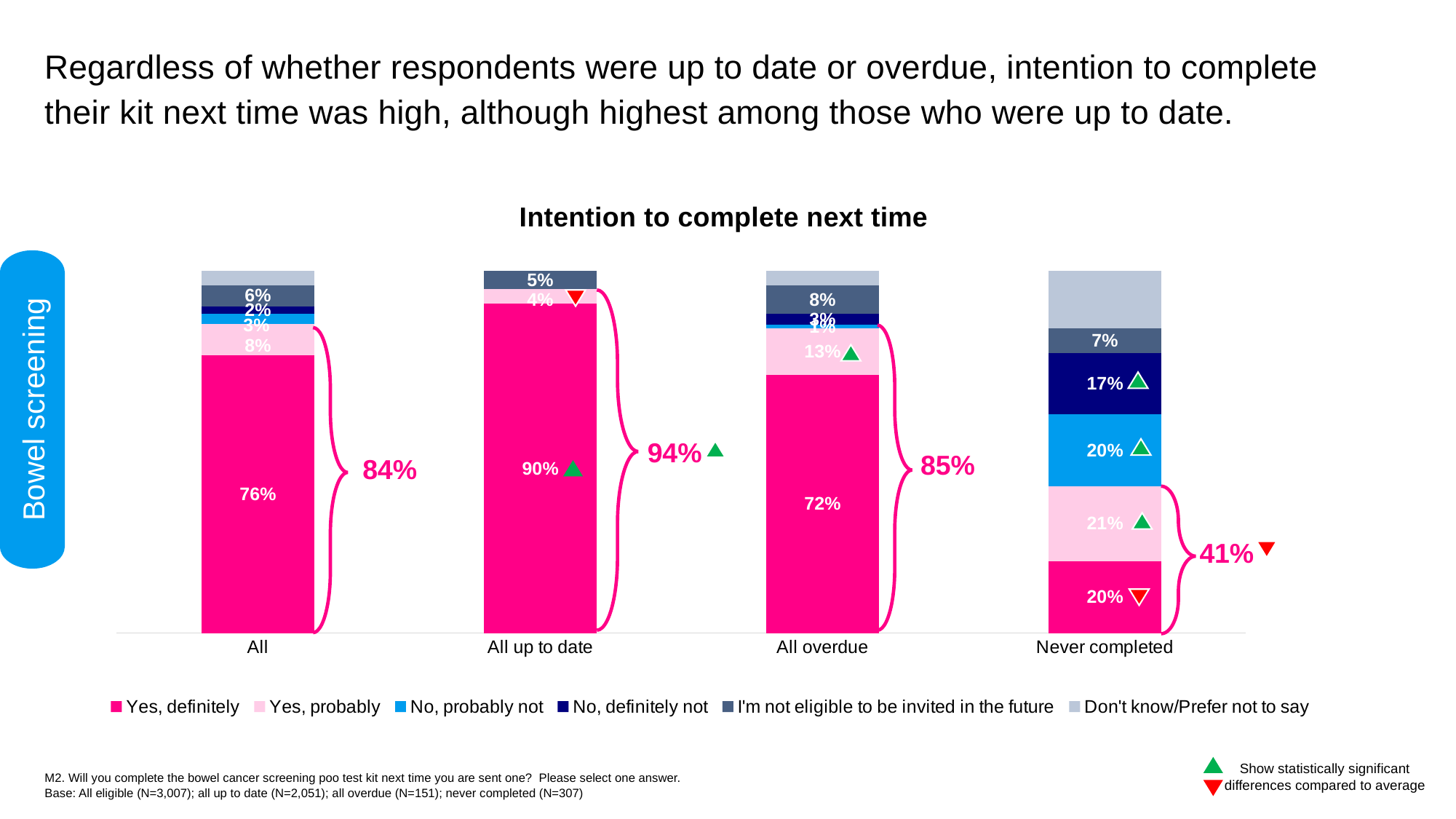
What is the title of the chart? Intention to complete next time What is the 'No, probably not' value for the 'Never completed' category? 20% What combined 'Yes' percentage is shown by the bracket for the 'Never completed' category? 41% How many series does the chart's legend list? 6 Which category has the lowest 'Yes, definitely' value? Never completed Which has the larger 'Yes, probably' value: 'All' or 'All overdue'? All overdue Which category has the highest 'Yes, definitely' value? All up to date What is the difference between the 'Yes, definitely' values for 'All up to date' and 'All overdue'? 18 percentage points How many categories are shown along the x axis of the chart? 4 What is the 'Yes, definitely' value for the 'All overdue' category? 72% What kind of chart is shown on the slide? Stacked bar chart What is the 'Yes, definitely' value for the 'All up to date' category? 90%